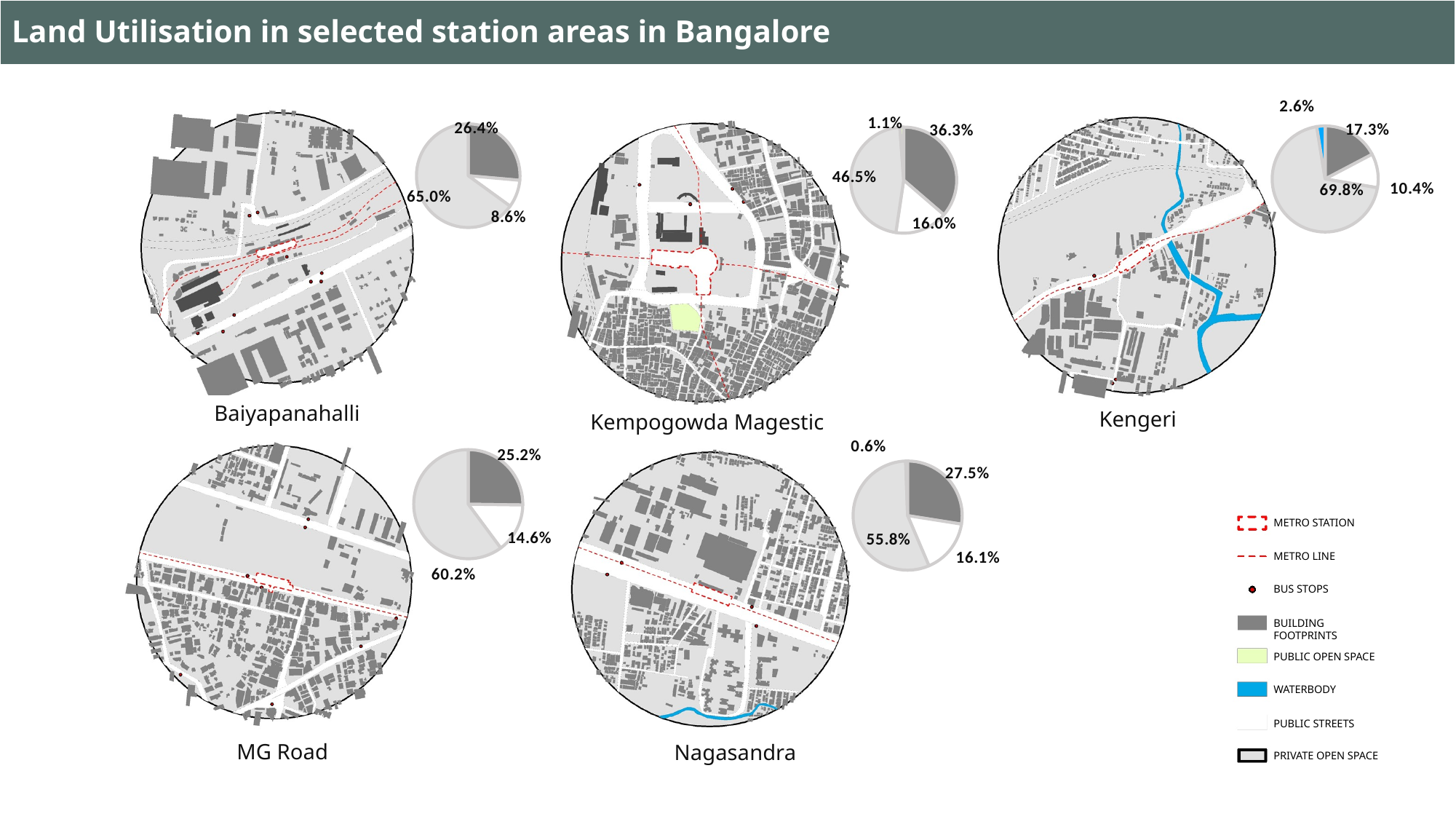
Which is larger: the dark grey slice in the Nagasandra pie chart or the dark grey slice in the Kengeri pie chart? Nagasandra (27.5%) In the Baiyapanahalli pie chart, what is the largest slice's value? 65.0% In the MG Road pie chart, what is the value of the dark grey slice? 25.2% How many pie charts are shown on the slide? 5 In the Baiyapanahalli pie chart, what is the smallest slice's value? 8.6% In the Kengeri pie chart, what is the value of the dark grey slice? 17.3% In the Kempogowda Magestic pie chart, what is the smallest slice's value? 1.1% In the Kempogowda Magestic pie chart, what is the largest slice's value? 46.5% In the Nagasandra pie chart, what is the smallest slice's value? 0.6% What kind of charts are shown next to each station area map on the slide? Pie charts How many slices does the Kempogowda Magestic pie chart have? 4 In the Kengeri pie chart, what is the largest slice's value? 69.8%